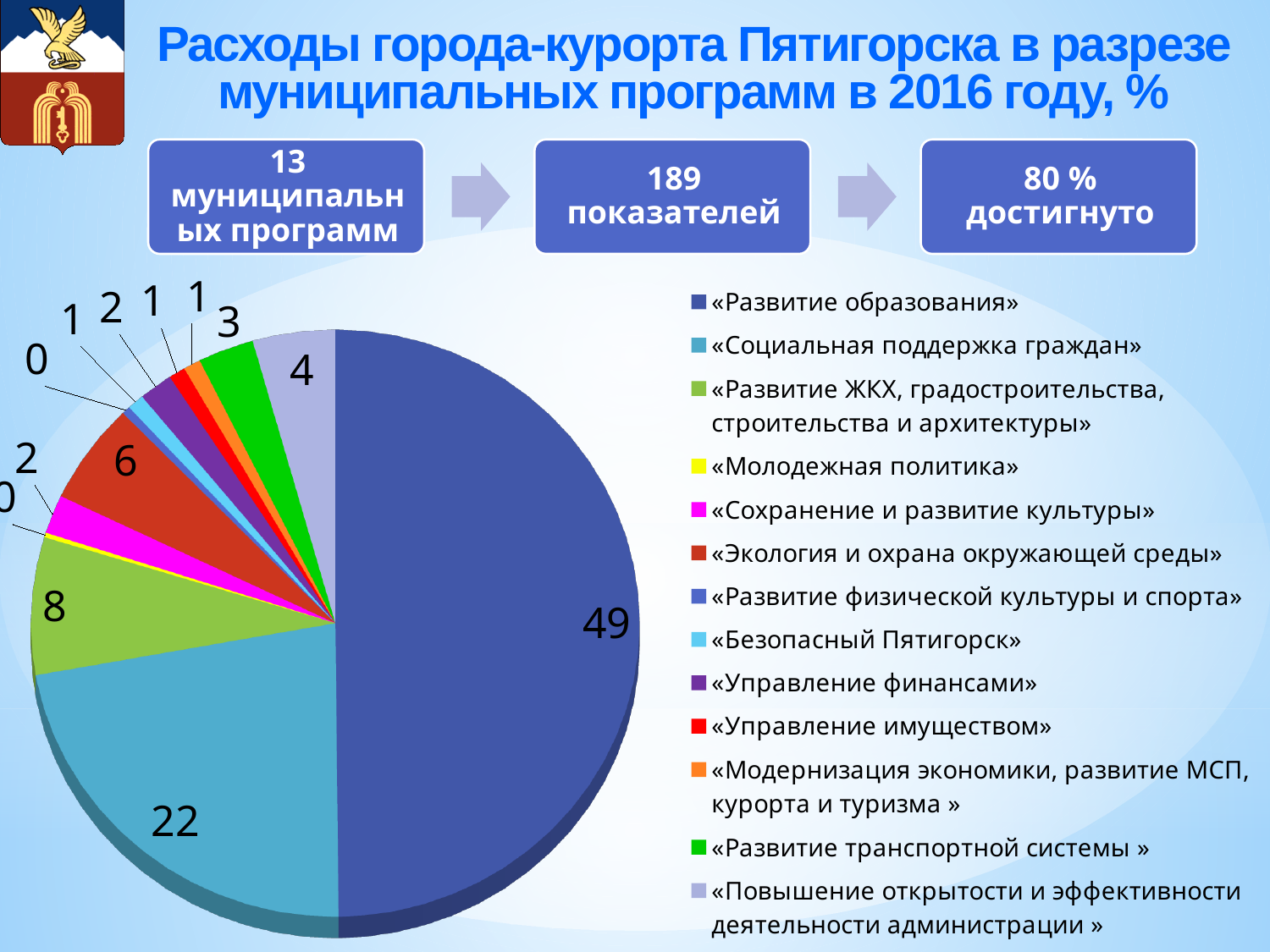
Which is larger: the value for «Развитие ЖКХ, градостроительства, строительства и архитектуры» or for «Экология и охрана окружающей среды»? «Развитие ЖКХ, градостроительства, строительства и архитектуры» How many entries does the legend of the pie chart list? 13 What value is shown for «Экология и охрана окружающей среды»? 6 What is the difference between the values for «Развитие образования» and «Социальная поддержка граждан»? 27 Which municipal program has the largest share of expenditures in the pie chart? «Развитие образования» What value is shown for «Повышение открытости и эффективности деятельности администрации»? 4 What kind of chart is shown on the slide? Pie chart What value is shown for «Развитие образования»? 49 What value is shown for «Социальная поддержка граждан»? 22 What is the title of the slide containing the pie chart? Расходы города-курорта Пятигорска в разрезе муниципальных программ в 2016 году, % What value is shown for «Развитие ЖКХ, градостроительства, строительства и архитектуры»? 8 How many slices does the pie chart have? 13